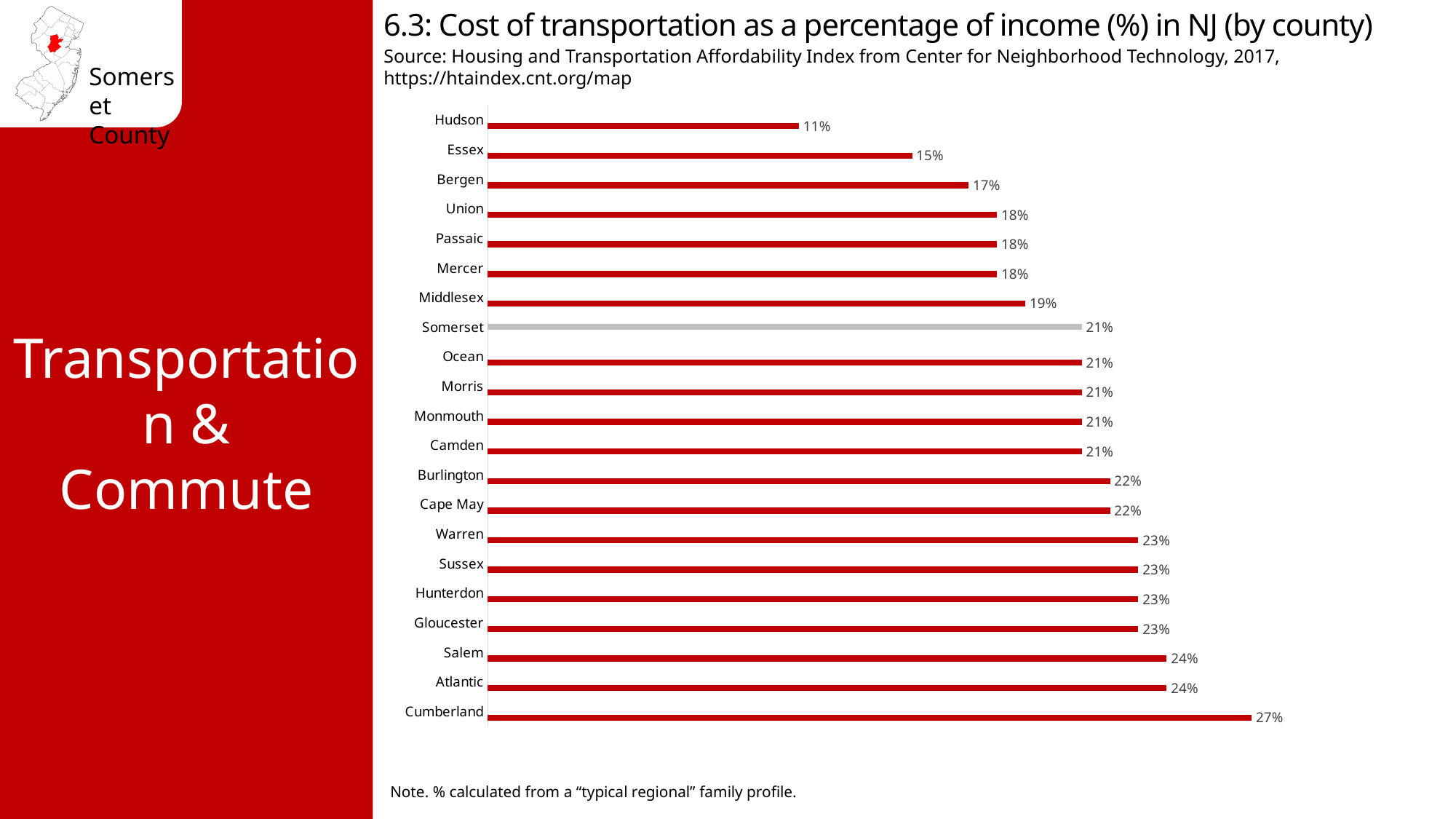
What is the title of the chart? 6.3: Cost of transportation as a percentage of income (%) in NJ (by county) What is the value shown for Middlesex County? 19% What is the difference between the values for Somerset and Bergen? 4% Which has a higher cost of transportation as a percentage of income, Essex or Salem? Salem What is the cost of transportation as a percentage of income for Hudson County? 11% Which county's bar is shown in a different colour (grey) from the others? Somerset How many counties are shown in the chart? 21 What is the cost of transportation as a percentage of income for Somerset County? 21% Which county has the lowest cost of transportation as a percentage of income? Hudson What is the difference between the values for Cumberland and Hudson? 16% Which county has the highest cost of transportation as a percentage of income? Cumberland What type of chart is shown on the slide? Bar chart